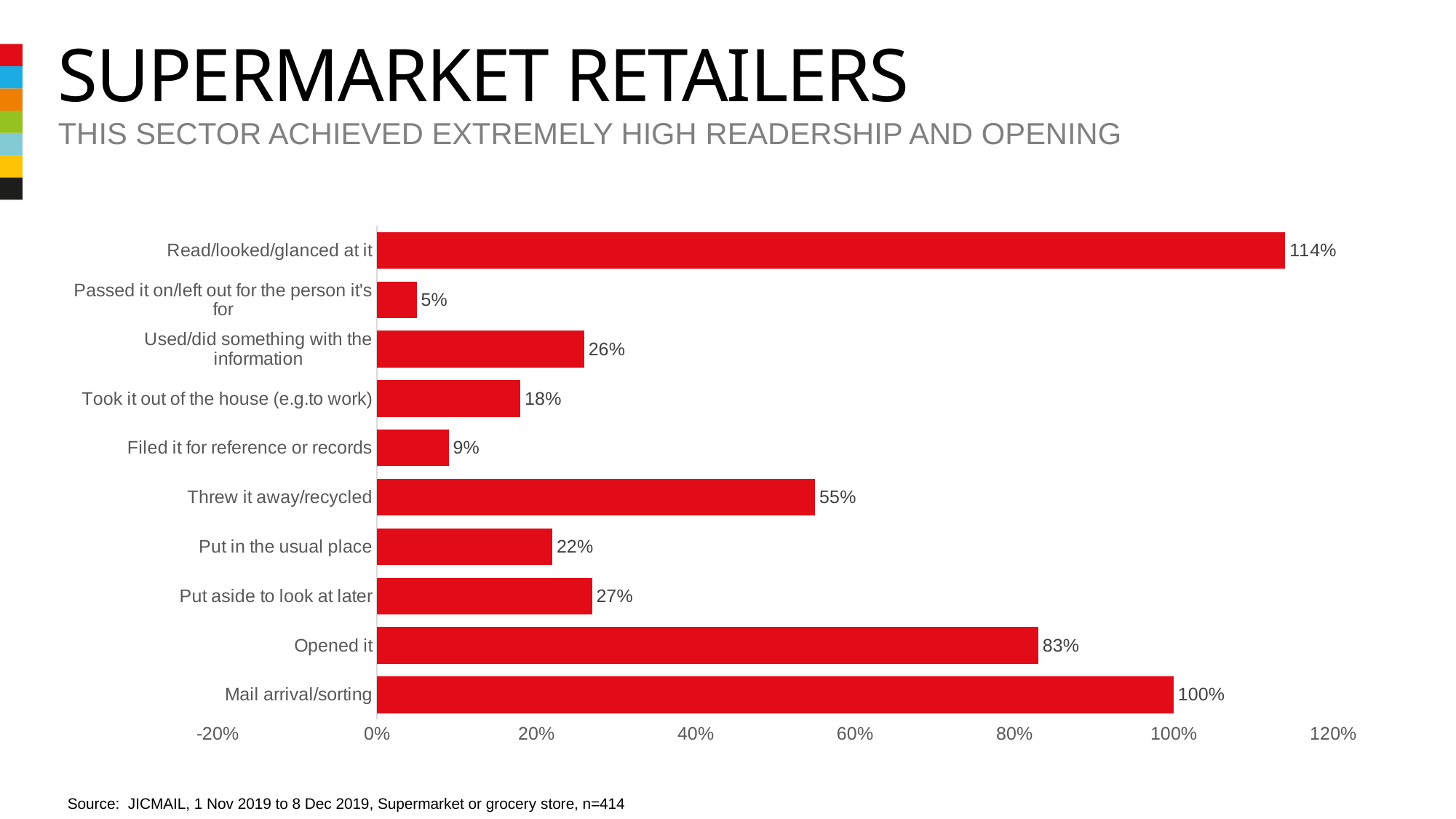
Which category has the highest value? Read/looked/glanced at it What colour are the bars in the chart? Red What is the value for "Read/looked/glanced at it"? 114% What is the difference between "Mail arrival/sorting" and "Opened it"? 17% What kind of chart is shown on the slide? Bar chart What is the difference between "Put aside to look at later" and "Put in the usual place"? 5% Which category has the lowest value? Passed it on/left out for the person it's for What is the value for "Threw it away/recycled"? 55% Which is larger, "Used/did something with the information" or "Took it out of the house (e.g.to work)"? Used/did something with the information How many categories are shown in the chart? 10 What is the value for "Filed it for reference or records"? 9% What is the value for "Opened it"? 83%